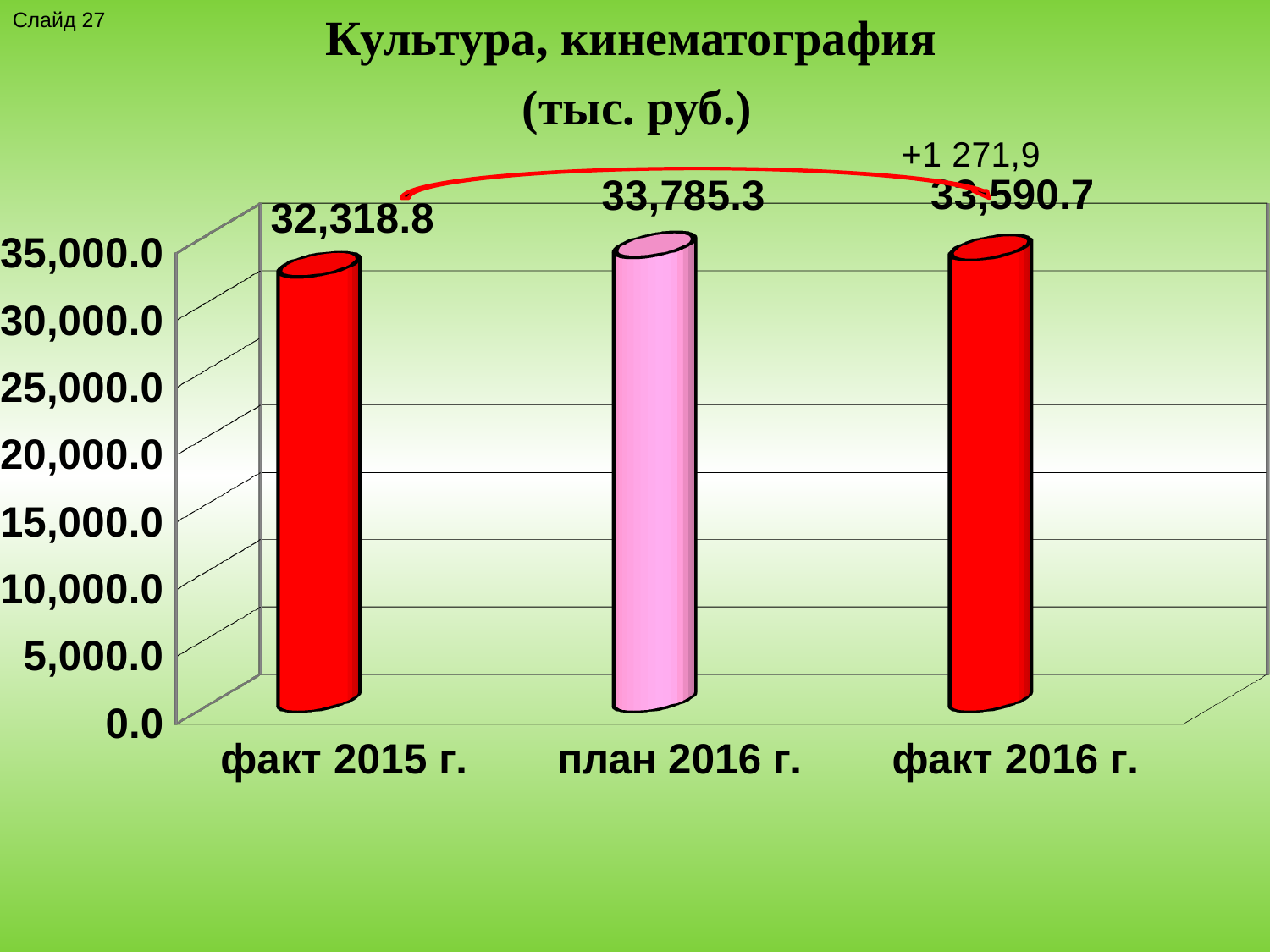
Which category has the lowest value? факт 2015 г. What is the value for факт 2016 г.? 33,590.7 Is the value for факт 2015 г. greater or less than 30,000.0? greater What kind of chart is shown on the slide? bar chart What is the difference between план 2016 г. and факт 2016 г.? 194.6 What is the value for факт 2015 г.? 32,318.8 What is the difference between факт 2016 г. and факт 2015 г.? 1,271.9 How many categories are shown on the chart? 3 What is the title of the chart? Культура, кинематография (тыс. руб.) What is the value for план 2016 г.? 33,785.3 Which category has the highest value? план 2016 г. Which is larger, the value for план 2016 г. or факт 2016 г.? план 2016 г.